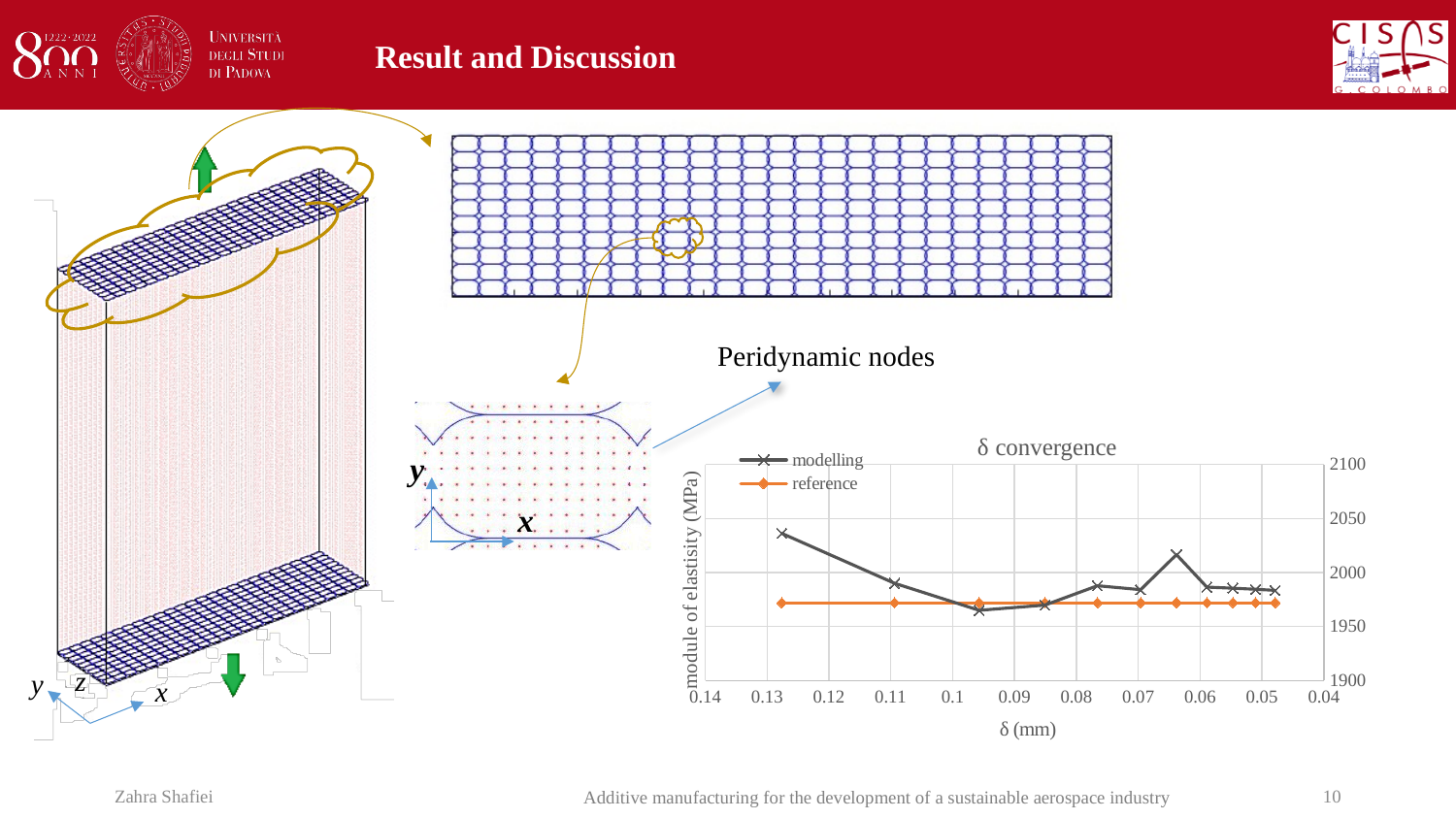
In the "δ convergence" chart, which series is higher at the leftmost data point (near δ = 0.13): modelling or reference? modelling In the "δ convergence" chart, is the leftmost modelling value (near δ = 0.13) greater or less than 2000? greater In the "δ convergence" chart, are the reference values greater or less than 1950? greater How many series does the legend of the "δ convergence" chart list? 2 In the "δ convergence" chart, does the reference series rise, fall, or stay flat along the x axis? stay flat In the "δ convergence" chart, which series reaches the highest value on the chart? modelling In the "δ convergence" chart, are the reference values greater or less than 2000? less What is the label of the vertical axis of the "δ convergence" chart? module of elasticity (MPa) What is the title of the chart on the slide? δ convergence In the "δ convergence" chart, does the modelling series overall rise or fall from the leftmost point to the rightmost point? fall What kind of chart is the "δ convergence" chart? line chart